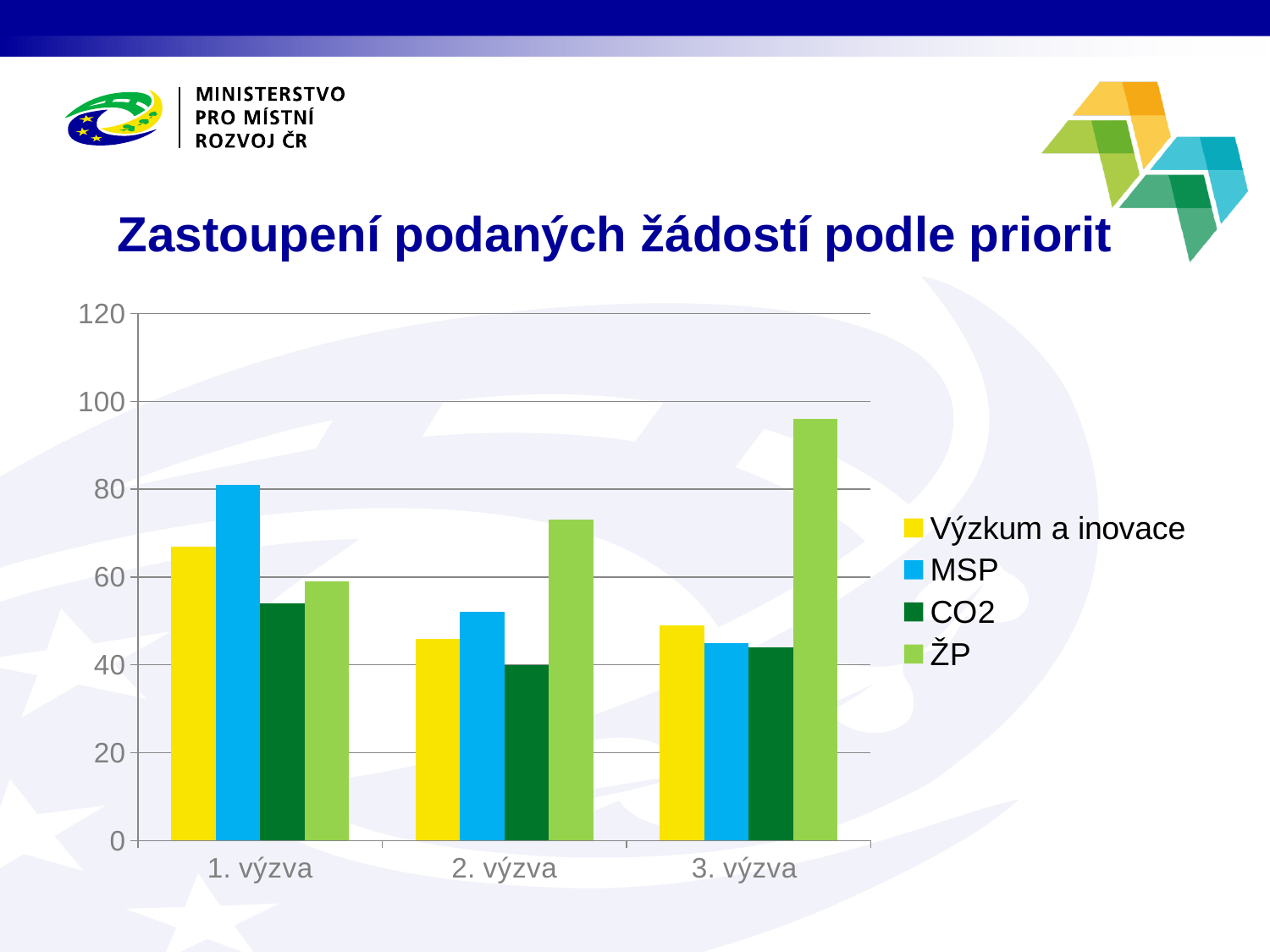
Which series has the highest value in 1. výzva? MSP Is the value for MSP in 1. výzva greater or less than 60? greater What is the title of the chart? Zastoupení podaných žádostí podle priorit How many series does the legend list? 4 Which series has the highest value in 3. výzva? ŽP Which is larger: ŽP in 2. výzva or Výzkum a inovace in 2. výzva? ŽP in 2. výzva Is the value for CO2 in 2. výzva greater or less than 60? less Which series has the lowest value in 2. výzva? CO2 Does the value for ŽP rise or fall from 1. výzva to 3. výzva? rise How many categories are shown on the x axis? 3 Is the value for ŽP in 3. výzva greater or less than 80? greater What kind of chart is shown on the slide? bar chart